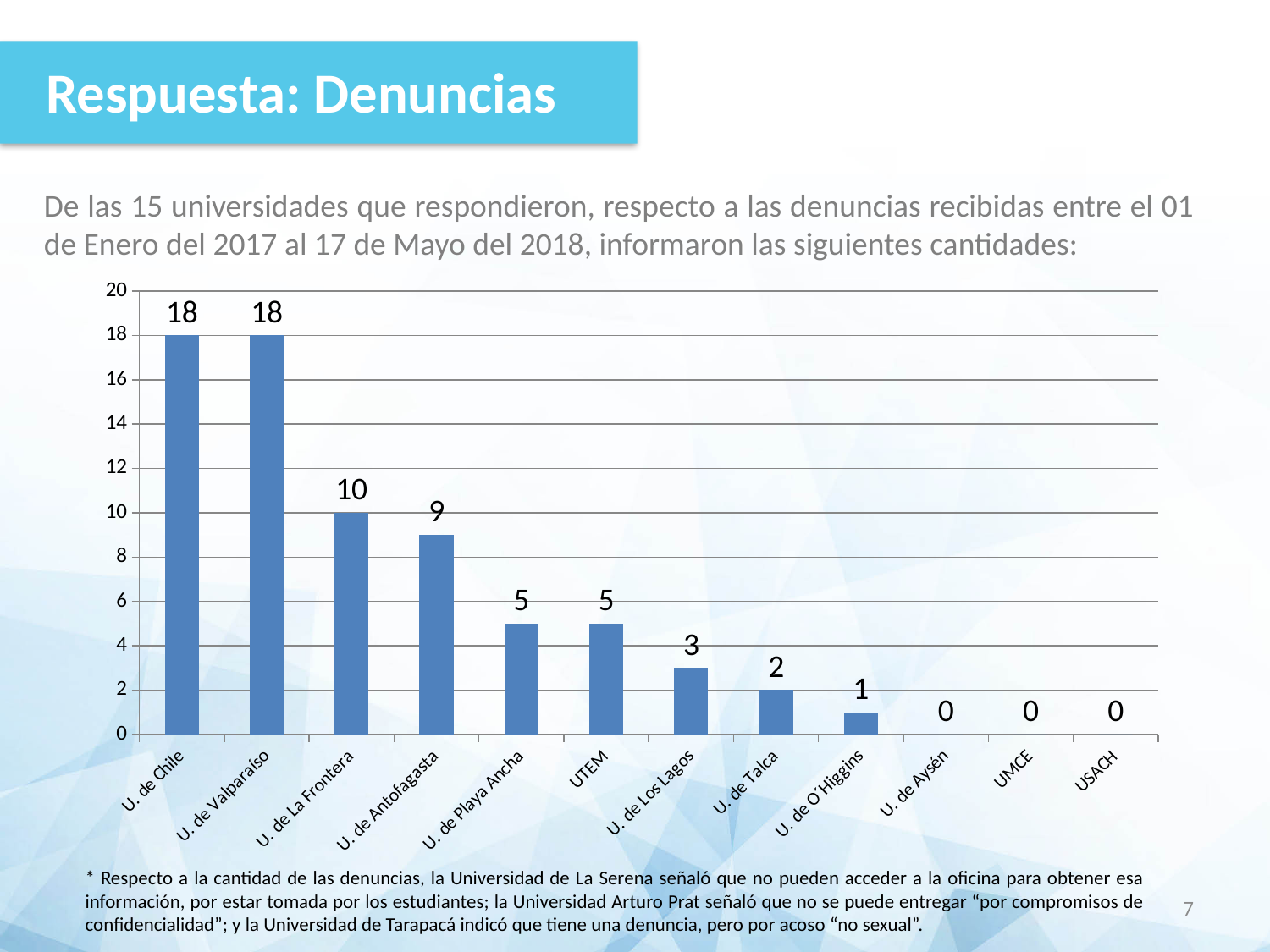
Do the values rise or fall from left to right along the x axis? Fall What is the value for UTEM? 5 What is the difference between the values for U. de La Frontera and U. de Playa Ancha? 5 What is the value for U. de Talca? 2 What is the difference between the values for U. de Chile and U. de Los Lagos? 15 How many categories are shown in the chart? 12 What is the value for U. de Antofagasta? 9 What kind of chart is shown on the slide? Bar chart Which has a larger value, U. de Antofagasta or U. de O'Higgins? U. de Antofagasta What is the highest value shown in the chart? 18 What is the value for U. de La Frontera? 10 What is the value for USACH? 0